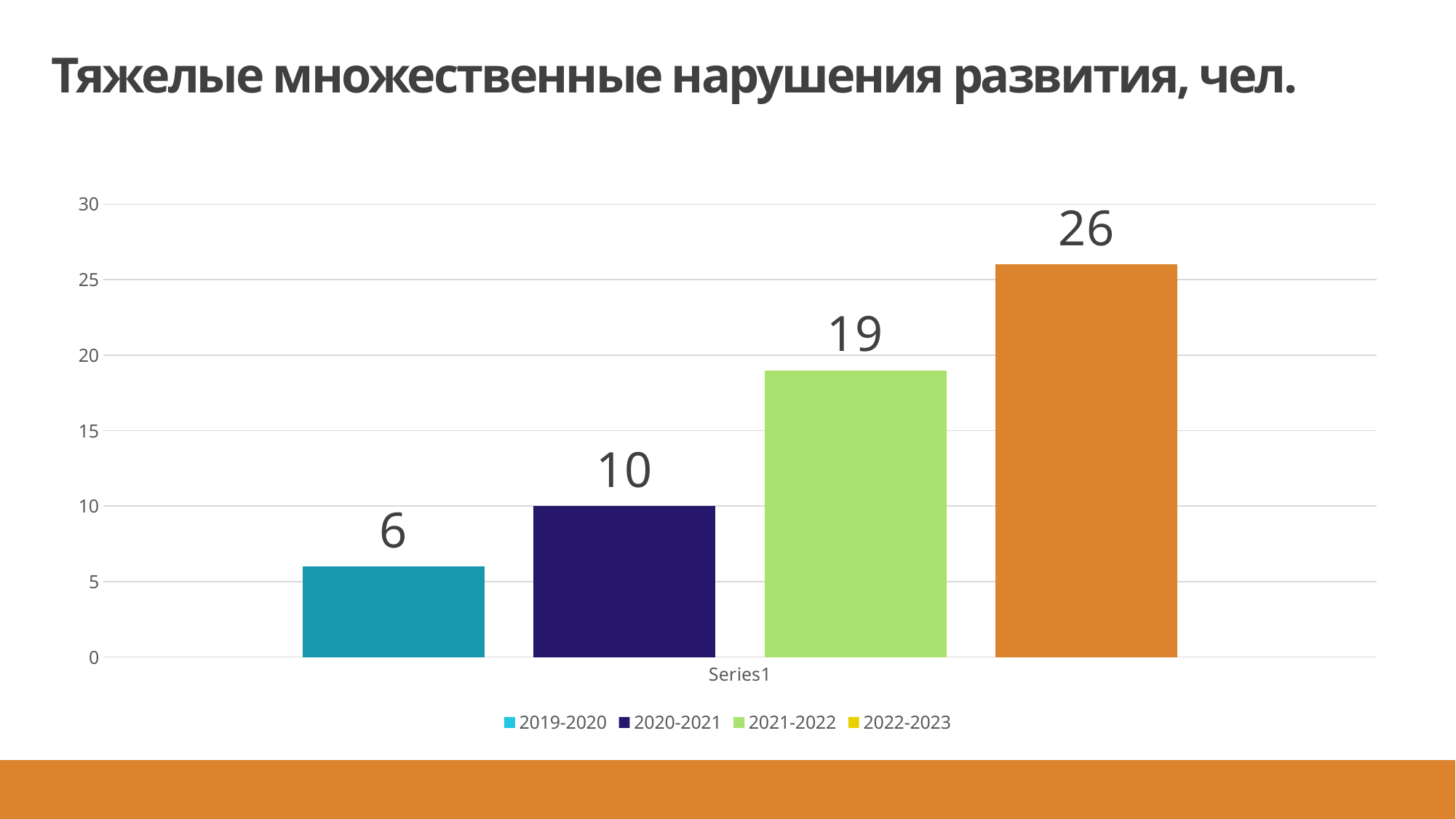
What is the value for 2022-2023? 26 How many bars are plotted on the chart? 4 What is the value for 2021-2022? 19 Which is larger, the value for 2020-2021 or the value for 2021-2022? 2021-2022 What is the value for 2019-2020? 6 What is the difference between the values for 2022-2023 and 2021-2022? 7 How many entries does the legend list? 4 Is the value for 2021-2022 greater or less than 15? greater Which period has the highest value? 2022-2023 Which period has the lowest value? 2019-2020 What is the value for 2020-2021? 10 What kind of chart is shown on the slide? bar chart